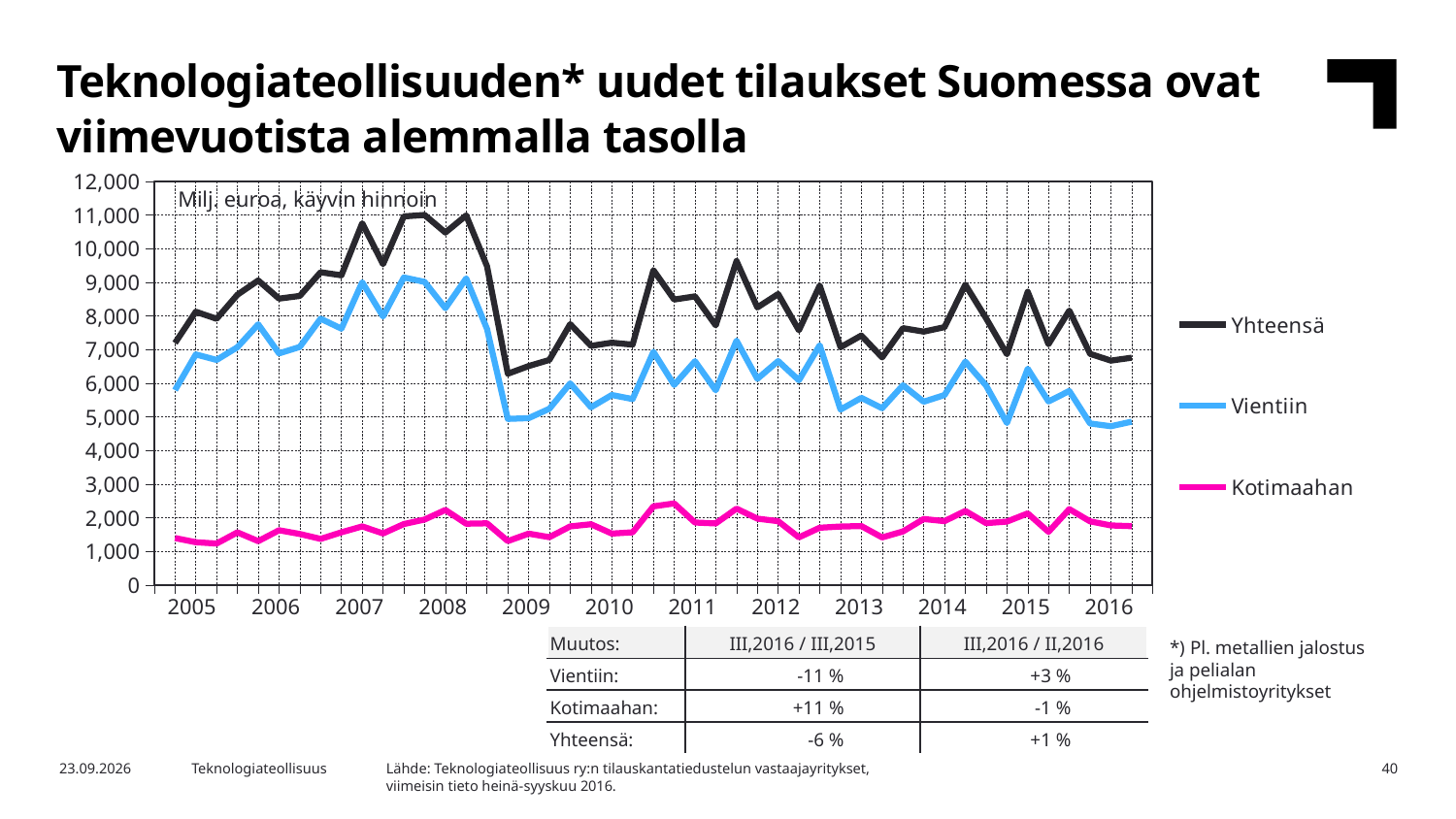
Which is larger in 2016, the value for Vientiin or the value for Kotimaahan? Vientiin How many series does the chart legend list? 3 Does the Yhteensä series rise or fall from 2008 to 2009? fall Is the value for Kotimaahan in 2005 greater or less than 3,000? less How many years are labelled on the x axis of the chart? 12 Is the value for Vientiin at the end of 2016 greater or less than 6,000? less Which series are listed in the chart legend? Yhteensä, Vientiin, Kotimaahan Which series has the highest values throughout the chart? Yhteensä What unit label is printed inside the chart area? Milj. euroa, käyvin hinnoin Which series has the lowest values throughout the chart? Kotimaahan What kind of chart is shown on the slide? Line chart Is the peak value of Yhteensä in 2008 greater or less than 10,000? greater